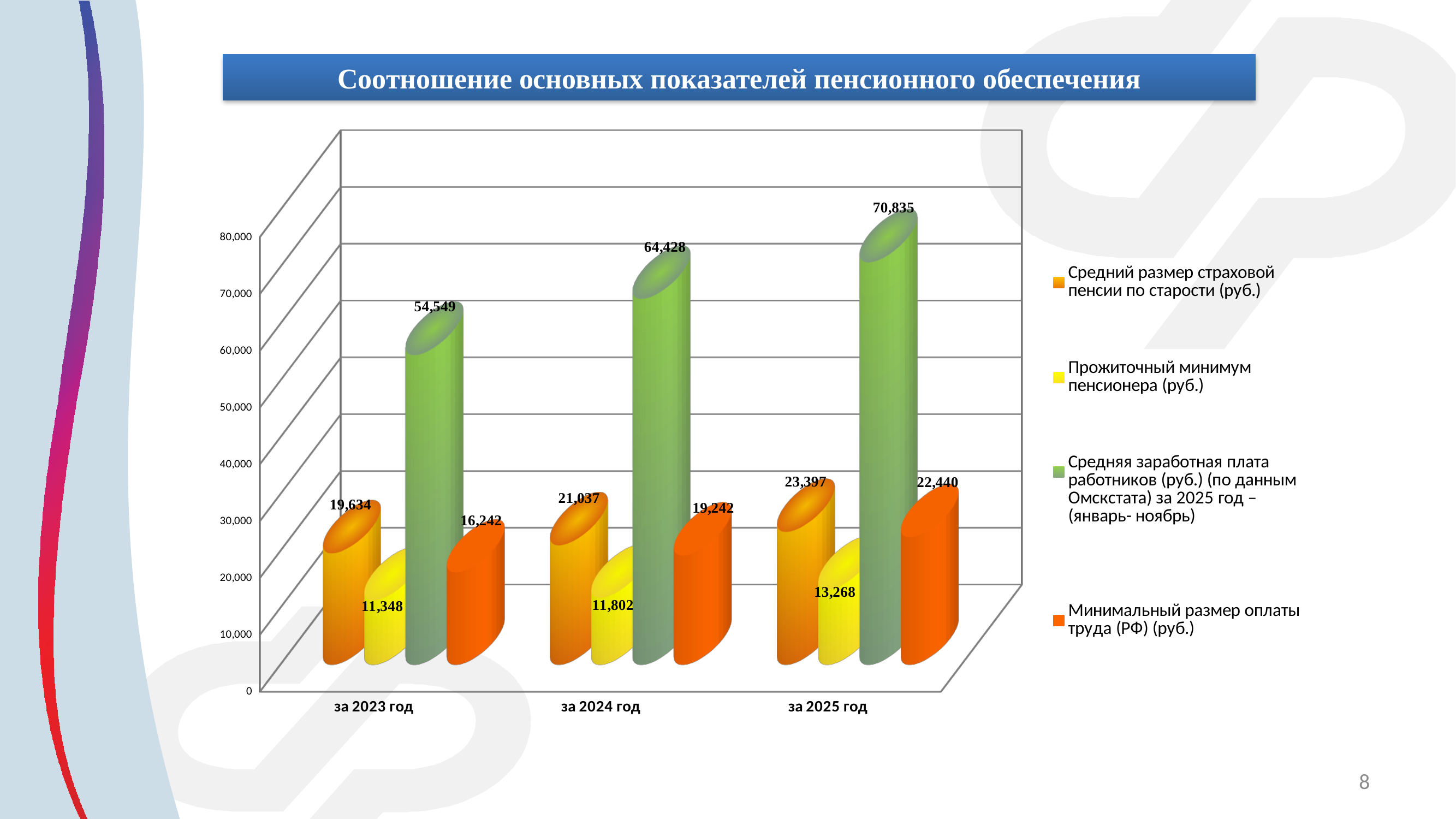
Which is larger for за 2024 год: Средний размер страховой пенсии по старости or Минимальный размер оплаты труда (РФ)? Средний размер страховой пенсии по старости What is the value of Минимальный размер оплаты труда (РФ) for за 2024 год? 19,242 Does Минимальный размер оплаты труда (РФ) rise or fall from за 2023 год to за 2025 год? Rise What is the value of Прожиточный минимум пенсионера for за 2023 год? 11,348 What is the difference between Средний размер страховой пенсии по старости for за 2025 год and за 2023 год? 3,763 What kind of chart is shown on the slide? Bar chart How many series does the legend list? 4 How many years are shown on the x axis? 3 What is the value of Средняя заработная плата работников for за 2025 год? 70,835 What is the value of Средний размер страховой пенсии по старости for за 2025 год? 23,397 In which year is Средняя заработная плата работников the highest? за 2025 год In which year is Прожиточный минимум пенсионера the lowest? за 2023 год